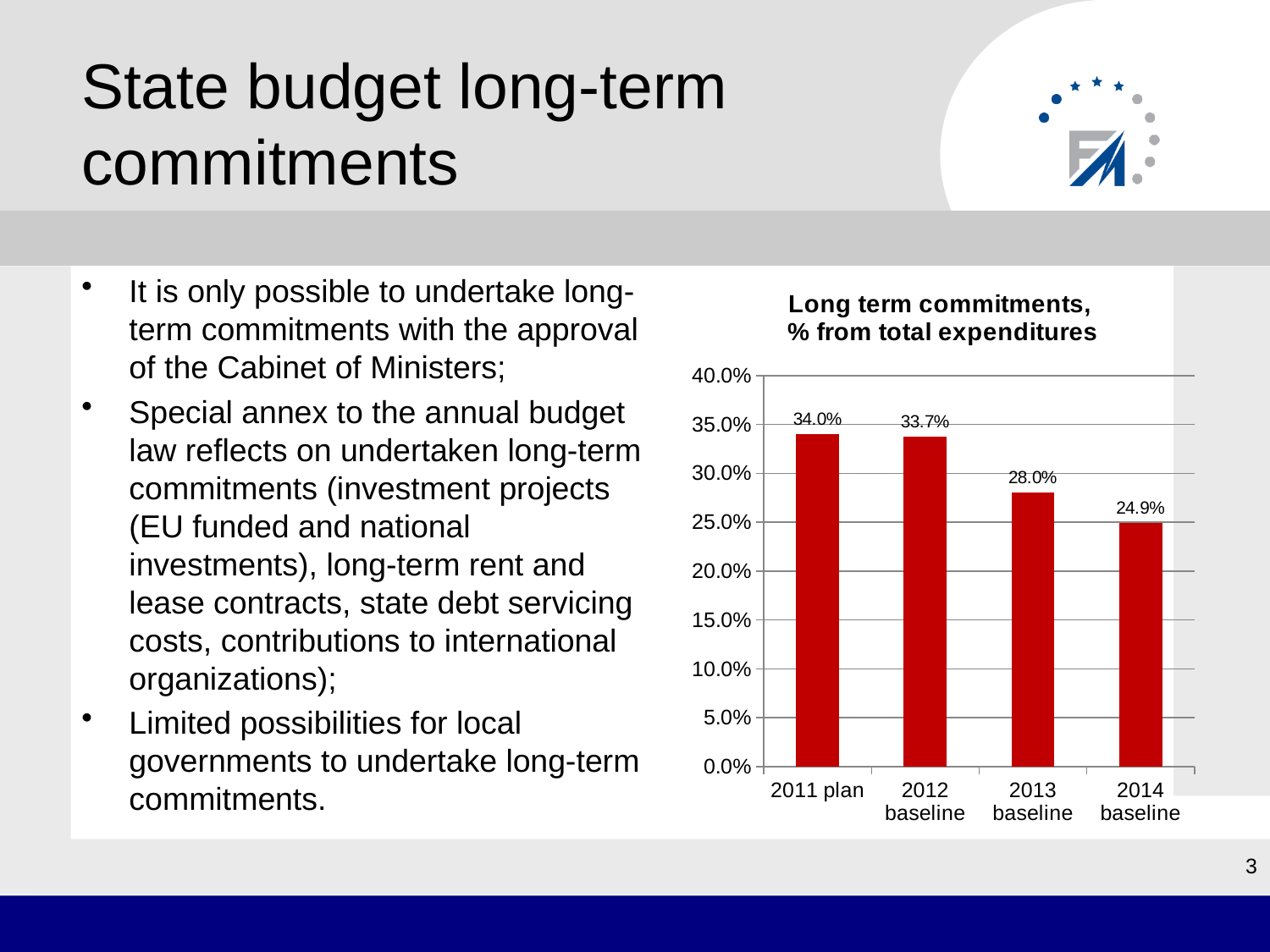
Which category has the lowest value? 2014 baseline How many categories are shown on the x axis? 4 What is the value for 2014 baseline? 24.9% Which is larger, the value for 2013 baseline or the value for 2014 baseline? 2013 baseline What is the value for 2012 baseline? 33.7% Do the values rise or fall from 2011 plan to 2014 baseline? fall What is the value for 2013 baseline? 28.0% What kind of chart is shown? bar chart Which category has the highest value? 2011 plan What is the difference between the values for 2011 plan and 2014 baseline? 9.1% What is the value for 2011 plan? 34.0% What is the difference between the values for 2013 baseline and 2014 baseline? 3.1%